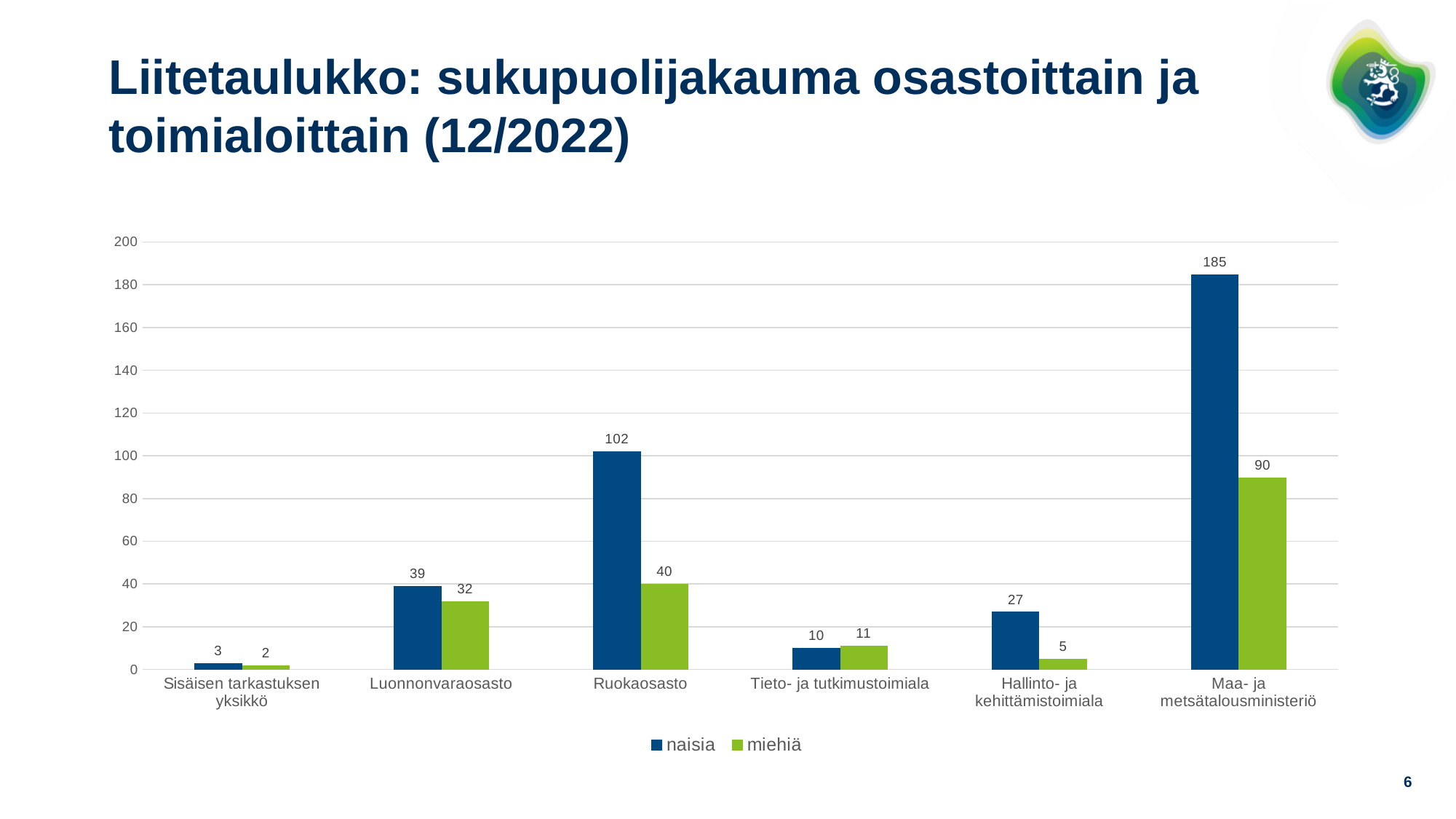
What is the value for miehiä in Luonnonvaraosasto? 32 Is the value for naisia in Ruokaosasto greater or less than 100? greater How many categories are shown on the x axis? 6 What is the value for miehiä in Hallinto- ja kehittämistoimiala? 5 What is the value for naisia in Ruokaosasto? 102 How many series does the legend list? 2 What is the total of naisia and miehiä in Luonnonvaraosasto? 71 Which category has the lowest value for miehiä? Sisäisen tarkastuksen yksikkö What kind of chart is shown on the slide? bar chart Which is larger in Tieto- ja tutkimustoimiala, naisia or miehiä? miehiä What is the difference between naisia and miehiä in Maa- ja metsätalousministeriö? 95 Which category has the highest value for naisia? Maa- ja metsätalousministeriö